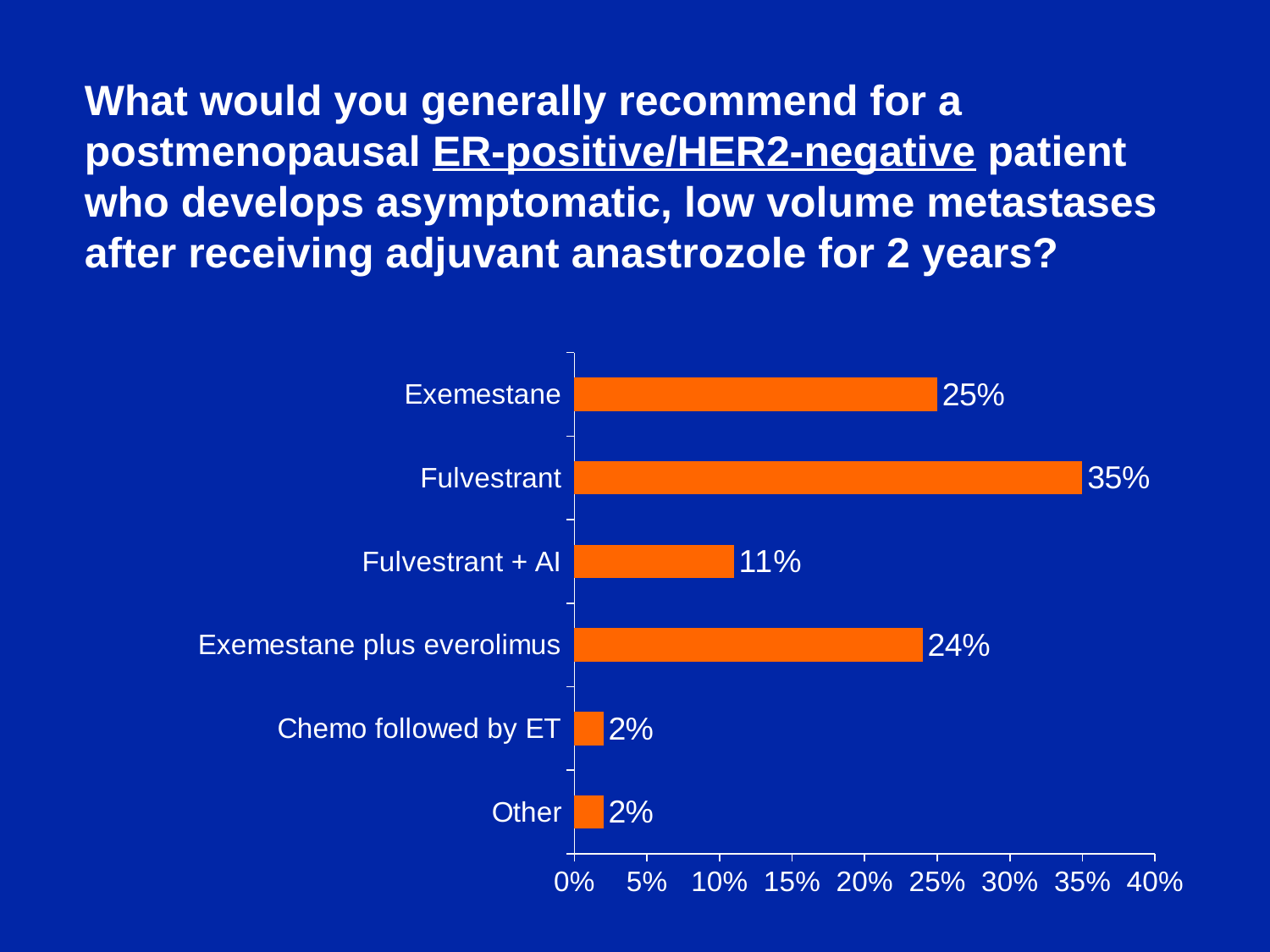
What is the difference between the percentages for Fulvestrant and Exemestane? 10% What percentage of respondents recommended Fulvestrant? 35% What percentage is shown for Fulvestrant + AI? 11% How many categories are shown in the chart? 6 Which option has the highest percentage? Fulvestrant What is the value shown for Exemestane plus everolimus? 24% What is the maximum value shown on the horizontal axis? 40% Which is larger, the value for Exemestane or the value for Exemestane plus everolimus? Exemestane What is the value shown for Chemo followed by ET? 2% What kind of chart is shown on the slide? Bar chart What is the difference between the values for Exemestane and Fulvestrant + AI? 14% Is the value for Fulvestrant greater or less than 30%? greater